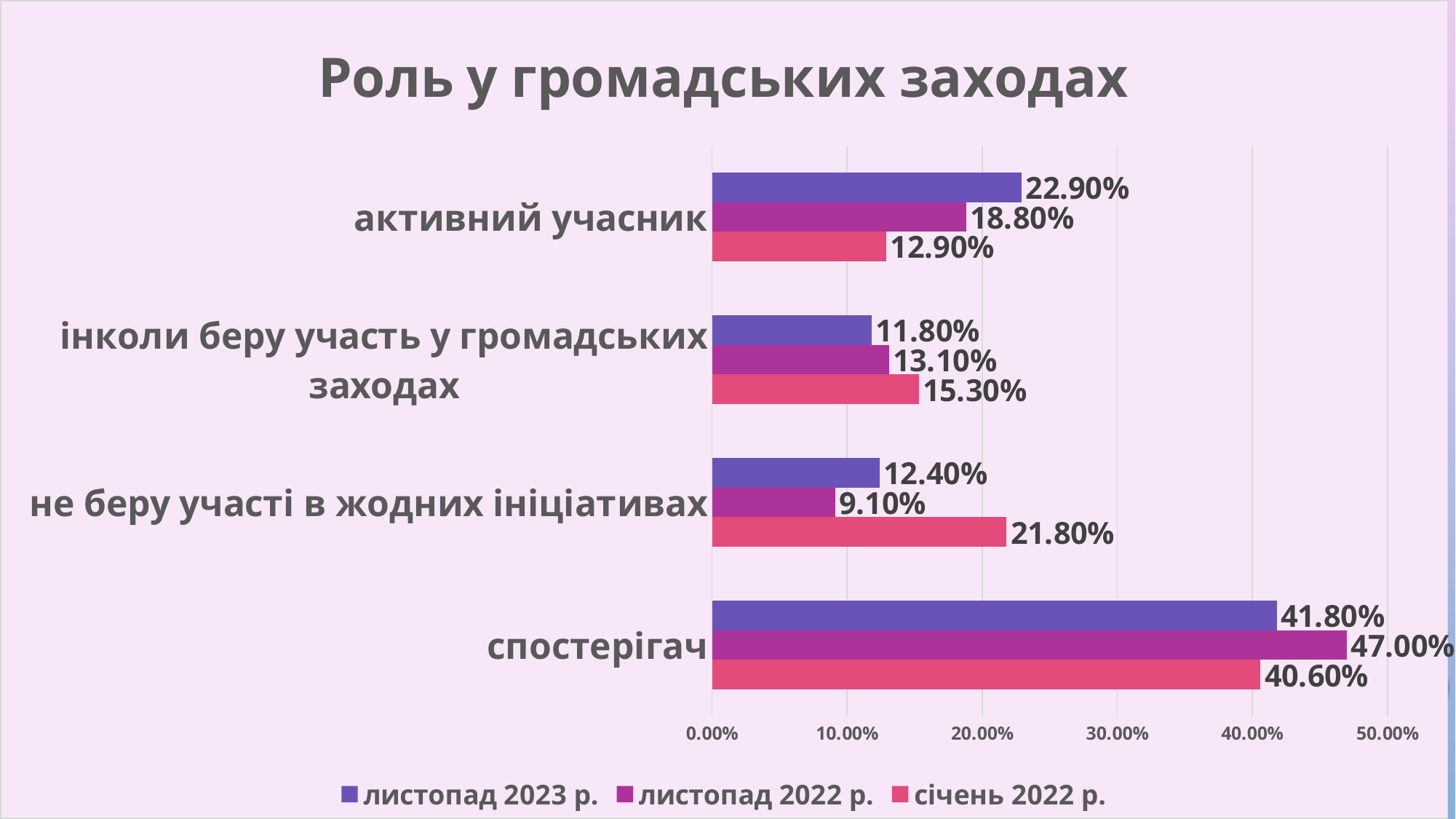
Which category has the lowest value in the «листопад 2022 р.» series? не беру участі в жодних ініціативах Is the «січень 2022 р.» value for «спостерігач» greater or less than 30.00%? greater How many series does the legend list? 3 For «інколи беру участь у громадських заходах», which series has the larger value: «листопад 2023 р.» or «січень 2022 р.»? січень 2022 р. What is the difference between the «листопад 2022 р.» and «листопад 2023 р.» values for «спостерігач»? 5.20% What is the value for «не беру участі в жодних ініціативах» in the «січень 2022 р.» series? 21.80% What is the value for «спостерігач» in the «листопад 2022 р.» series? 47.00% What kind of chart is shown on the slide? bar chart What is the title of the chart? Роль у громадських заходах Which category has the highest value in the «листопад 2023 р.» series? спостерігач How many categories are shown on the chart? 4 What is the value for «активний учасник» in the «листопад 2023 р.» series? 22.90%